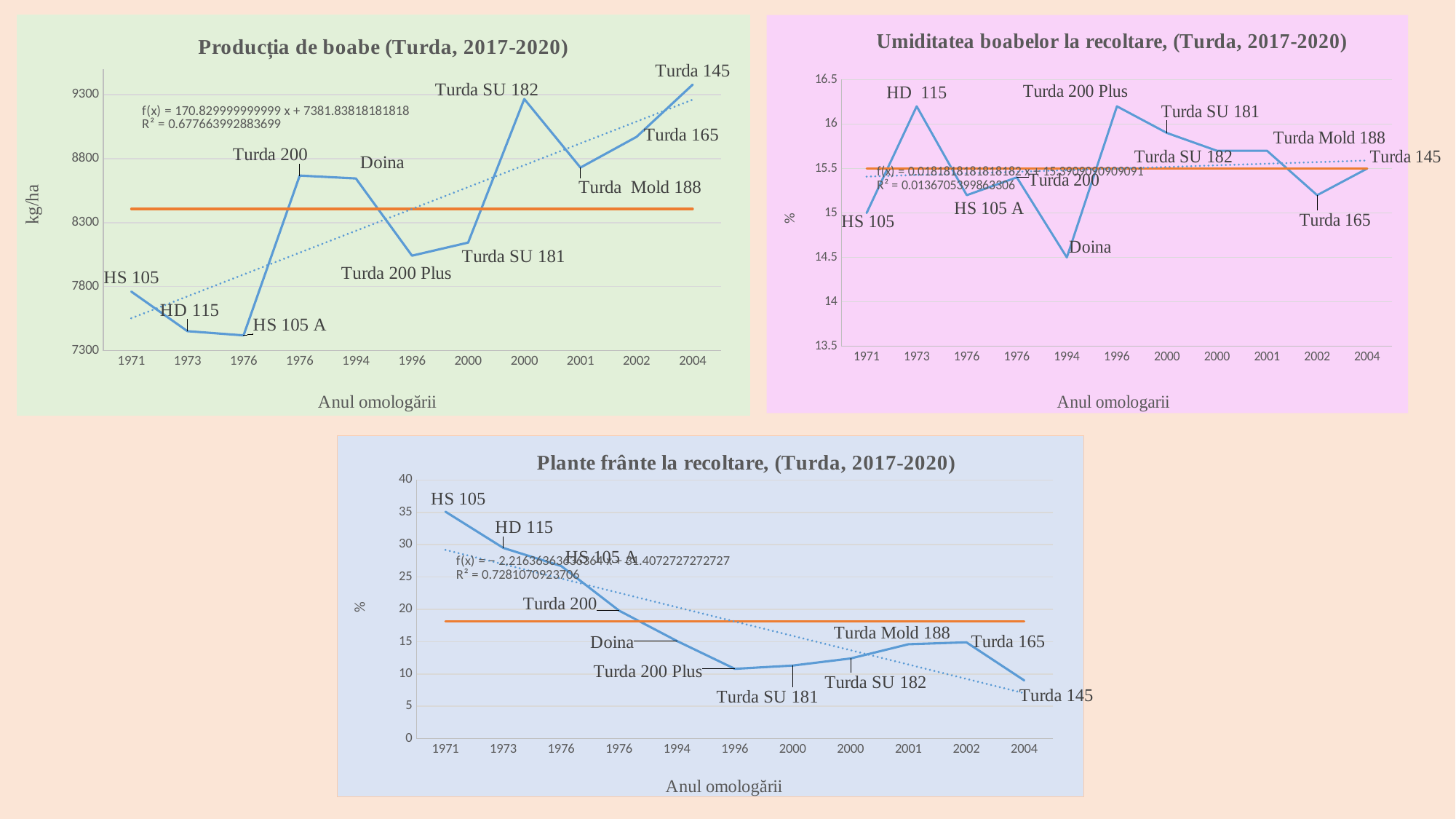
In the chart titled "Producția de boabe (Turda, 2017-2020)", what unit is shown on the vertical axis? kg/ha In the chart titled "Plante frânte la recoltare, (Turda, 2017-2020)", is the value for Turda 145 greater or less than 10? less In the chart titled "Plante frânte la recoltare, (Turda, 2017-2020)", which labelled point has the lowest value? Turda 145 In the chart titled "Plante frânte la recoltare, (Turda, 2017-2020)", do the values generally rise or fall from left to right along the x axis? fall In the chart titled "Producția de boabe (Turda, 2017-2020)", is the value for HS 105 A greater or less than 7800? less In the chart titled "Producția de boabe (Turda, 2017-2020)", which labelled point has the highest value? Turda 145 In the chart titled "Umiditatea boabelor la recoltare, (Turda, 2017-2020)", is the value for HD 115 greater or less than 16? greater In the chart titled "Umiditatea boabelor la recoltare, (Turda, 2017-2020)", which labelled point has the lowest value? Doina In the chart titled "Producția de boabe (Turda, 2017-2020)", which is larger, the value for Turda SU 182 or the value for Turda SU 181? Turda SU 182 In the chart titled "Producția de boabe (Turda, 2017-2020)", how many data points are plotted on the line? 11 In the chart titled "Plante frânte la recoltare, (Turda, 2017-2020)", which labelled point has the highest value? HS 105 In the chart titled "Umiditatea boabelor la recoltare, (Turda, 2017-2020)", what kind of chart is used? line chart